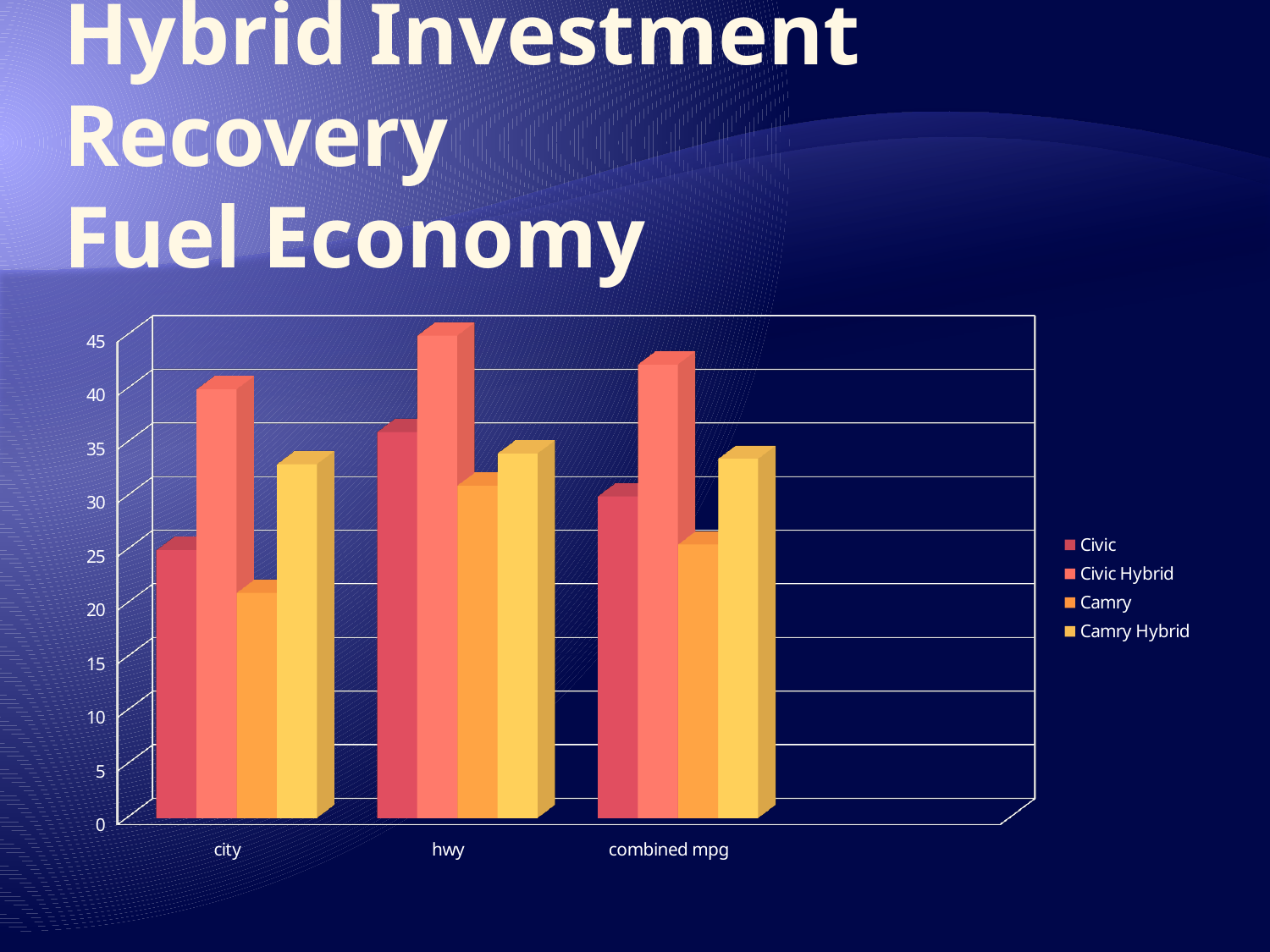
Which series has the lowest value in the combined mpg category? Camry Which series has the highest value in the city category? Civic Hybrid What kind of chart is shown on the slide? bar chart Which series is shown in the lightest yellow colour in the legend? Camry Hybrid Is the value for Camry in the combined mpg category greater or less than 30? less In the city category, which is larger: the value for Civic or the value for Camry Hybrid? Camry Hybrid Which series has the lowest value in the city category? Camry How many categories are shown on the x axis? 3 How many series does the legend list? 4 Is the value for Civic in the city category greater or less than 30? less Which series has the highest value in the hwy category? Civic Hybrid Is the value for Civic Hybrid in the hwy category greater or less than 40? greater